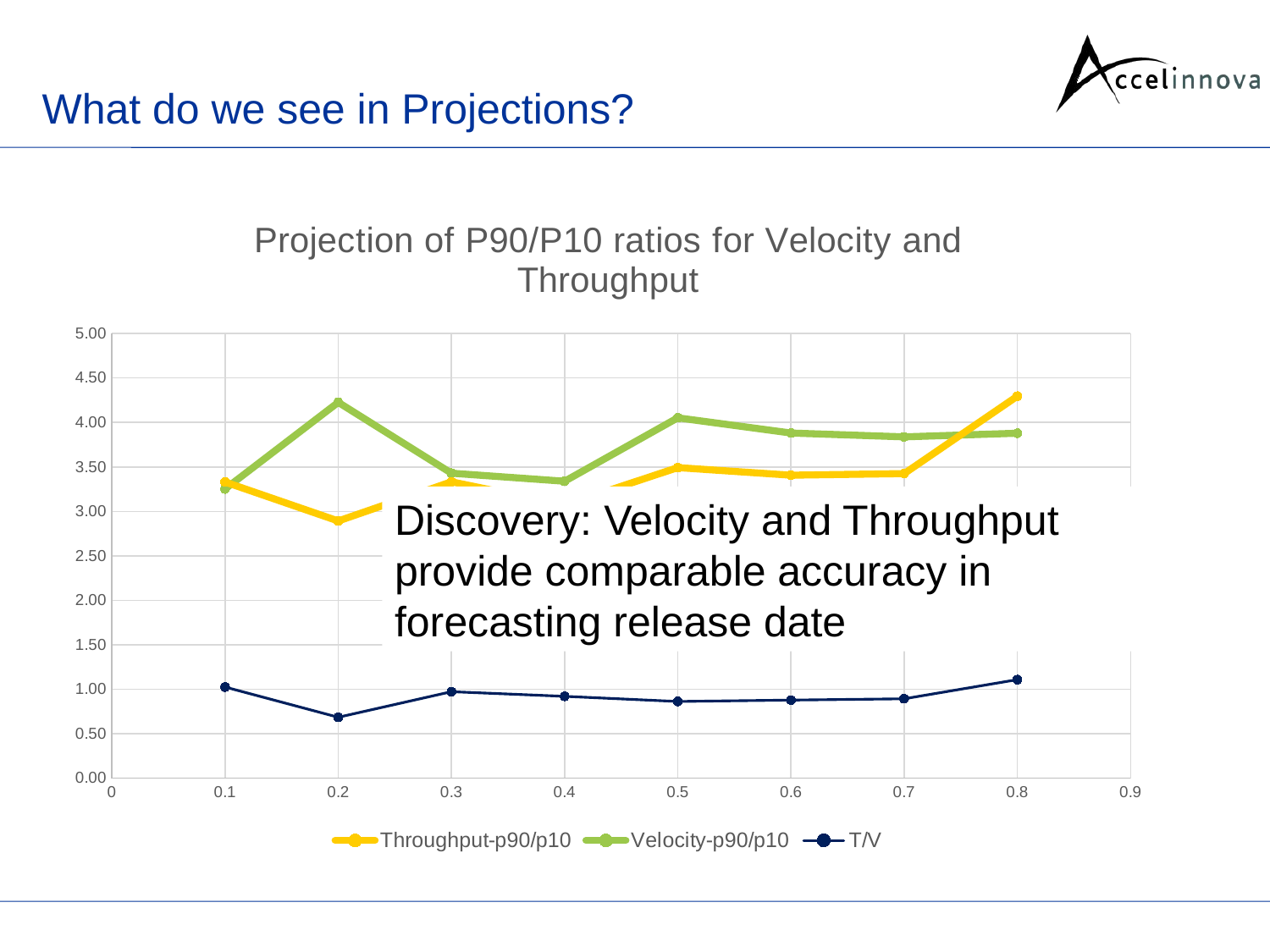
At x = 0.8, which series has the larger value, Throughput-p90/p10 or Velocity-p90/p10? Throughput-p90/p10 At x = 0.2, which series has the larger value, Throughput-p90/p10 or Velocity-p90/p10? Velocity-p90/p10 What kind of chart is shown on the slide? line chart At which x value does the Throughput-p90/p10 series reach its highest point? 0.8 At which x value is the Throughput-p90/p10 series at its lowest? 0.2 At which x value does the Velocity-p90/p10 series reach its highest point? 0.2 Is the T/V value at x = 0.2 greater or less than 1.00? less At which x value is the T/V series at its lowest? 0.2 Is the Velocity-p90/p10 value at x = 0.2 greater or less than 4.00? greater How many series does the legend list? 3 How many data points are plotted for the Velocity-p90/p10 series? 8 What is the title of the chart? Projection of P90/P10 ratios for Velocity and Throughput